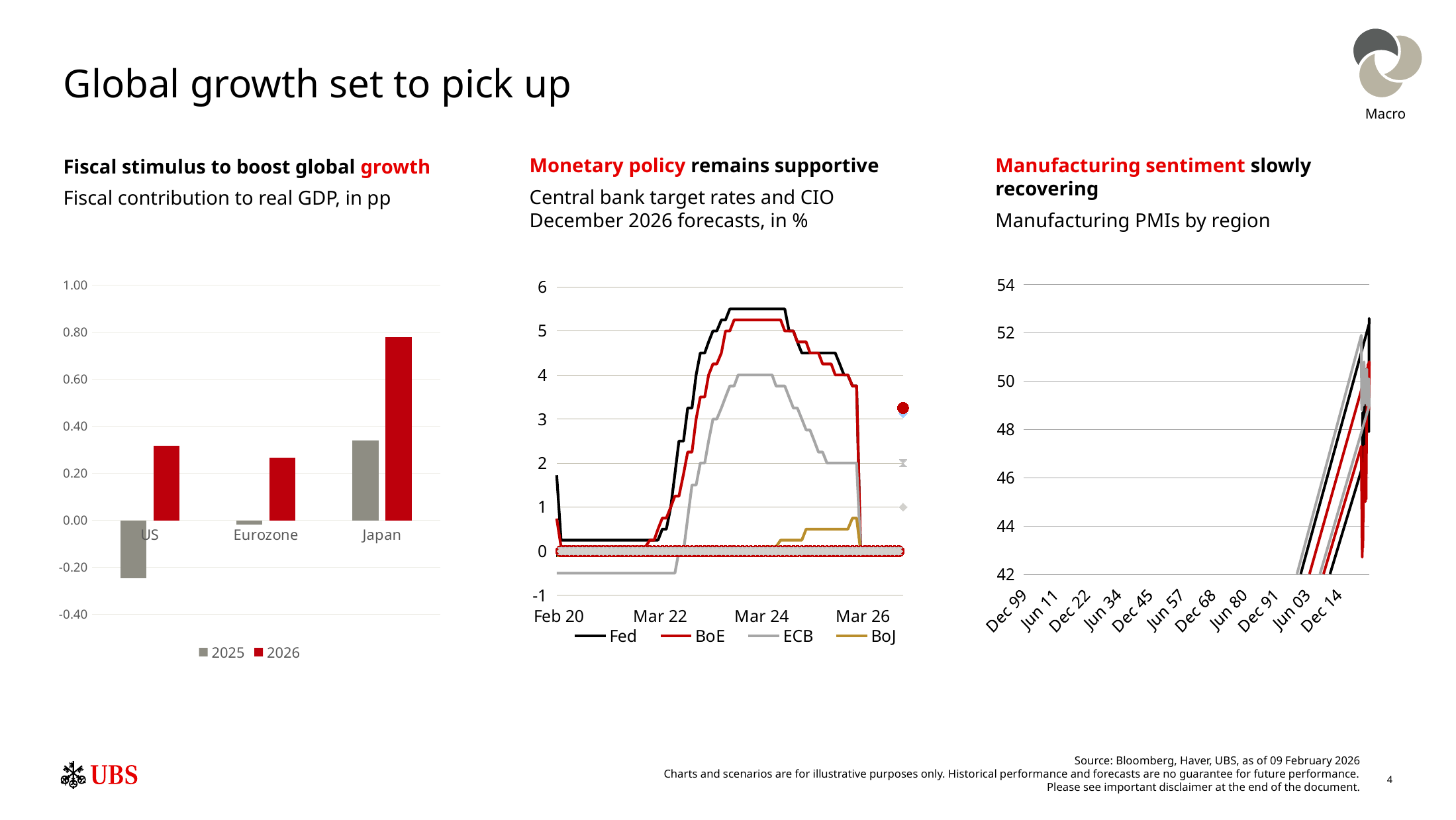
How many series does the legend of the 'Central bank target rates and CIO December 2026 forecasts, in %' chart list? 4 How many series does the legend of the 'Fiscal contribution to real GDP, in pp' chart list? 2 In the 'Fiscal contribution to real GDP, in pp' chart, which category has the lowest 2025 value? US How many categories are shown on the x axis of the 'Fiscal contribution to real GDP, in pp' bar chart? 3 In the 'Fiscal contribution to real GDP, in pp' chart, which is larger: the 2025 value for Japan or the 2025 value for Eurozone? Japan In the 'Central bank target rates and CIO December 2026 forecasts, in %' chart, is the peak value of the Fed line greater or less than 5? greater What kind of chart is the 'Manufacturing PMIs by region' chart on the right? Line chart In the 'Fiscal contribution to real GDP, in pp' chart, is the 2025 value for US greater or less than 0.00? less In the 'Central bank target rates and CIO December 2026 forecasts, in %' chart, does the Fed line rise or fall between Mar 24 and Mar 26? fall In the 'Fiscal contribution to real GDP, in pp' chart, which category has the highest 2026 value? Japan In the 'Fiscal contribution to real GDP, in pp' chart, is the 2026 value for Japan greater or less than 0.60? greater What kind of chart is the 'Fiscal contribution to real GDP, in pp' chart on the left? Bar chart